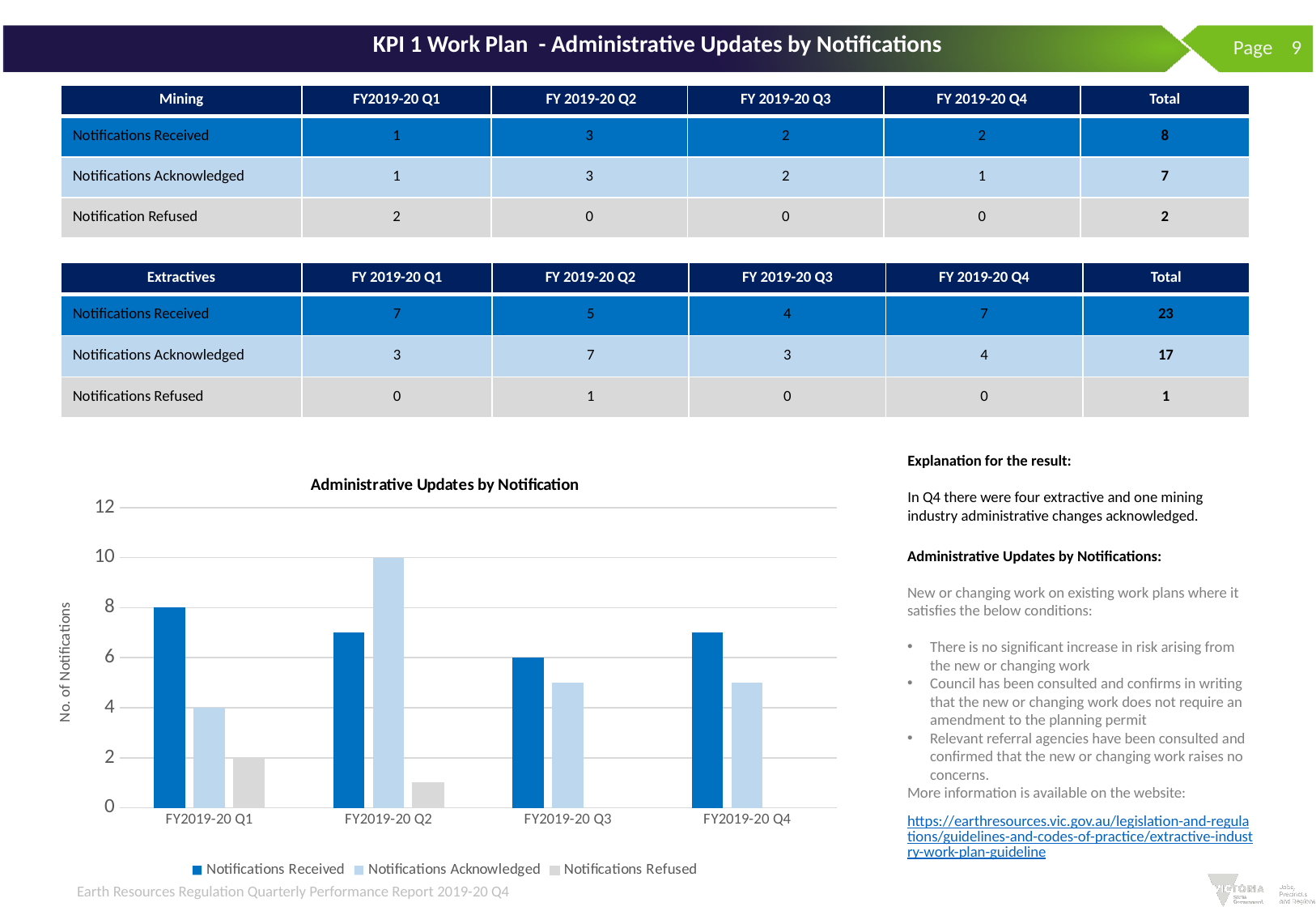
In the 'Administrative Updates by Notification' chart, is the value of Notifications Received for FY2019-20 Q2 greater or less than 6? greater What type of chart is 'Administrative Updates by Notification'? bar chart What is the y-axis title of the 'Administrative Updates by Notification' chart? No. of Notifications In the 'Administrative Updates by Notification' chart, what is the value of Notifications Acknowledged for FY2019-20 Q2? 10 In the 'Administrative Updates by Notification' chart, which quarter has the highest Notifications Received bar? FY2019-20 Q1 In the 'Administrative Updates by Notification' chart, which quarter has the highest Notifications Acknowledged bar? FY2019-20 Q2 In the 'Administrative Updates by Notification' chart, what is the value of Notifications Received for FY2019-20 Q1? 8 In the 'Administrative Updates by Notification' chart, what is the difference between Notifications Received and Notifications Acknowledged for FY2019-20 Q1? 4 How many quarters are shown on the x axis of the 'Administrative Updates by Notification' chart? 4 In the 'Administrative Updates by Notification' chart, what is the value of Notifications Received for FY2019-20 Q3? 6 How many series does the legend of the 'Administrative Updates by Notification' chart list? 3 In the 'Administrative Updates by Notification' chart, is the value of Notifications Acknowledged for FY2019-20 Q4 greater or less than 4? greater